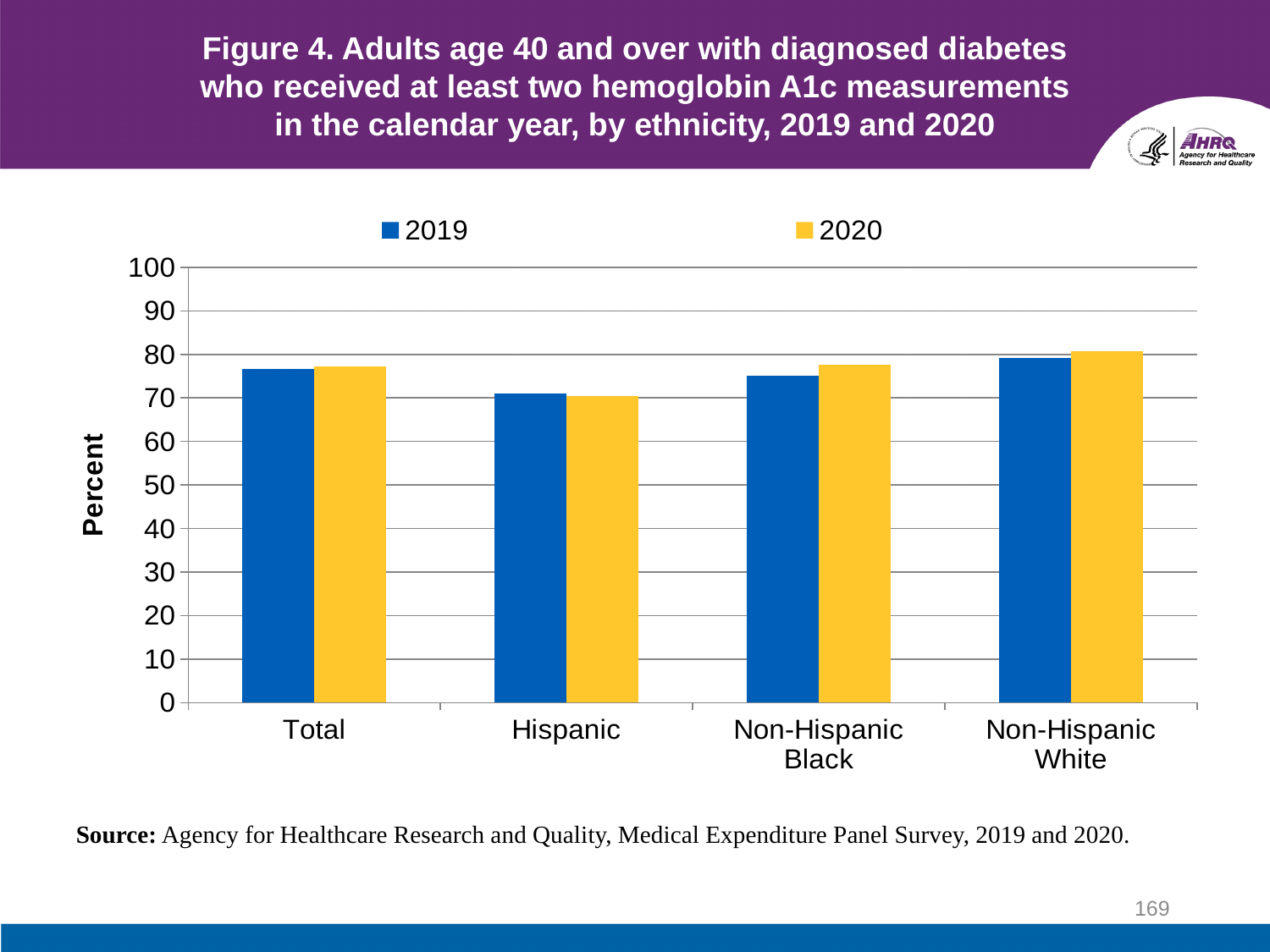
Which category has the highest value for 2020? Non-Hispanic White Which category has the highest value for 2019? Non-Hispanic White Which category has the lowest value for 2019? Hispanic What is the label on the y axis? Percent For Non-Hispanic Black, which year has the larger value, 2019 or 2020? 2020 What kind of chart is shown on the slide? bar chart Which category has the lowest value for 2020? Hispanic How many ethnicity categories are shown on the x axis? 4 Which colour represents the 2020 series in the legend? yellow How many series does the legend list? 2 Is the value for Non-Hispanic White in 2019 greater or less than 70? greater Is the value for Hispanic in 2020 greater or less than 80? less